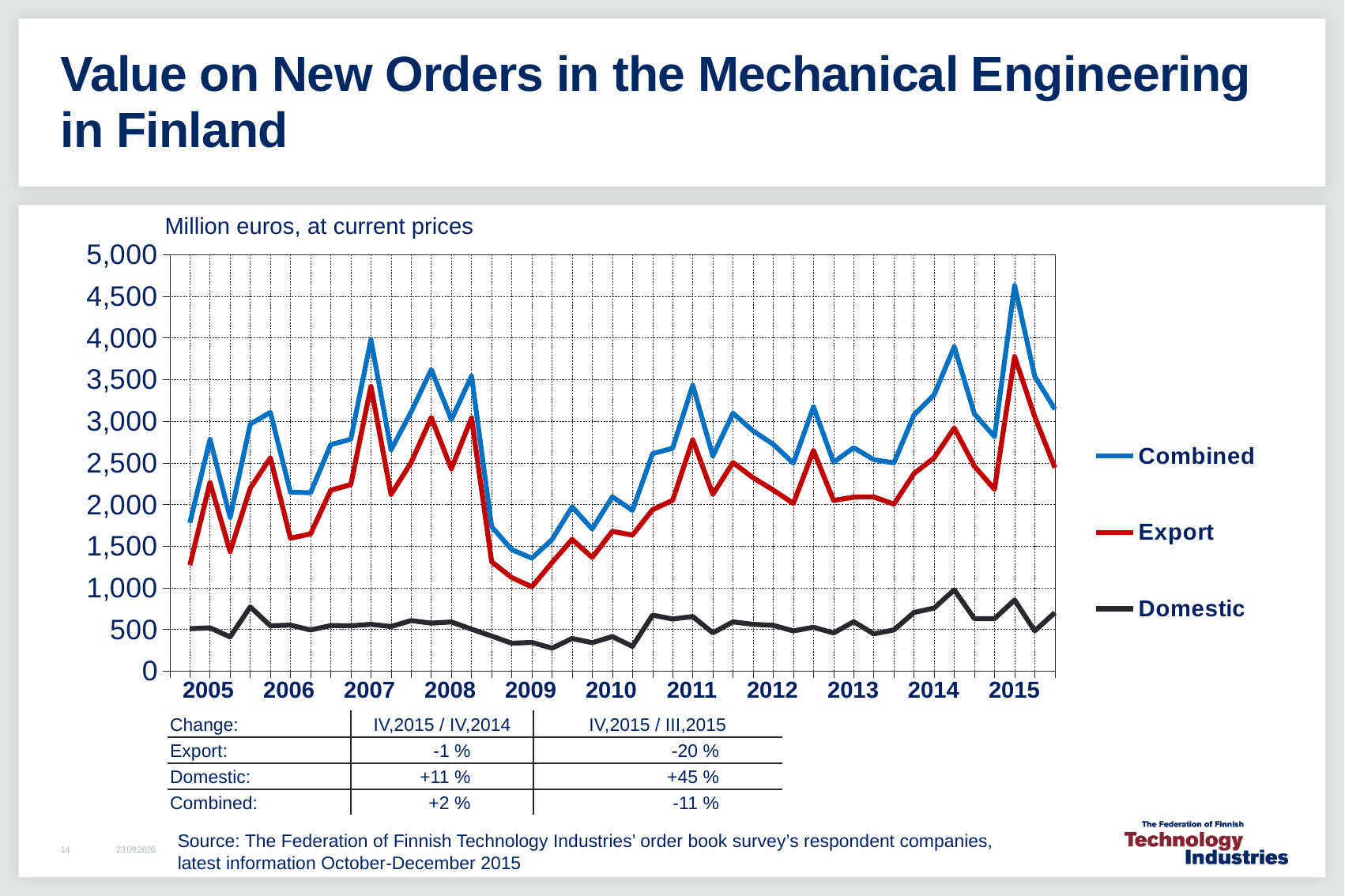
Is the lowest value of the Combined series in 2009 greater or less than 1,500? less What unit is stated above the chart? Million euros, at current prices Is the Domestic value at the start of 2009 greater or less than 500? less What kind of chart is shown on the slide? line chart Which series reaches the highest value on the chart? Combined Does the Combined series rise or fall between the end of 2008 and the start of 2009? fall Which series is plotted in red? Export How many years are labelled on the x axis? 11 Is the peak value of the Combined series in 2015 greater or less than 4,500? greater How many series does the legend list? 3 Which series has the lowest values throughout the whole period? Domestic